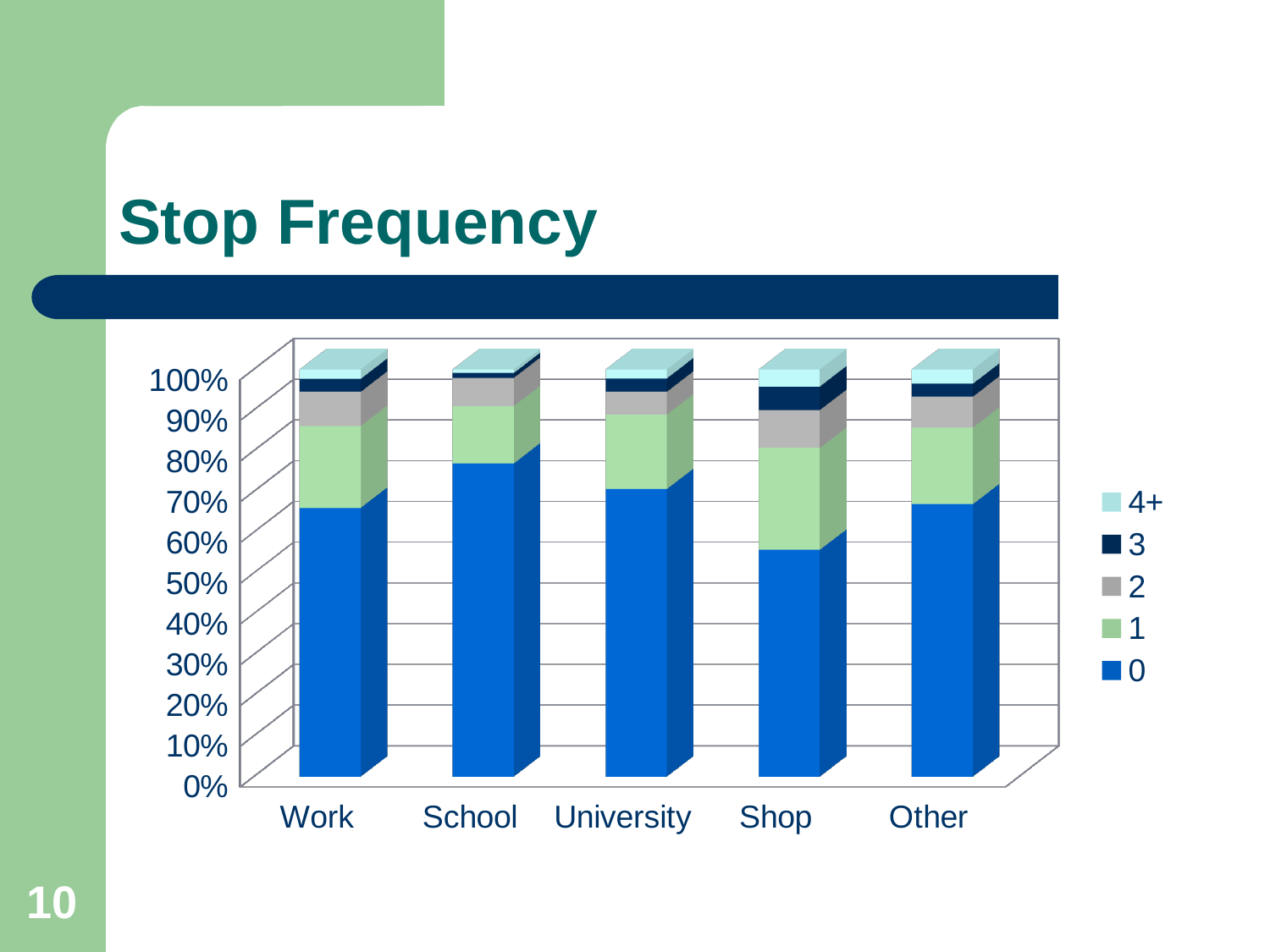
Is the share of the '0' series for School greater or less than 70%? greater What kind of chart is shown on the slide? stacked bar chart Is the share of the '0' series for Work greater or less than 60%? greater What is the title of the slide containing the chart? Stop Frequency Which has a larger share for the '0' series, Work or Shop? Work Which legend entry is shown in the lightest blue colour at the top of the legend? 4+ Which category has the smallest share for the '0' series? Shop How many categories are shown along the x axis of the chart? 5 Which has a larger share for the '0' series, School or University? School Which category has the largest share for the '0' series? School Is the share of the '0' series for Shop greater or less than 60%? less How many series does the chart's legend list? 5